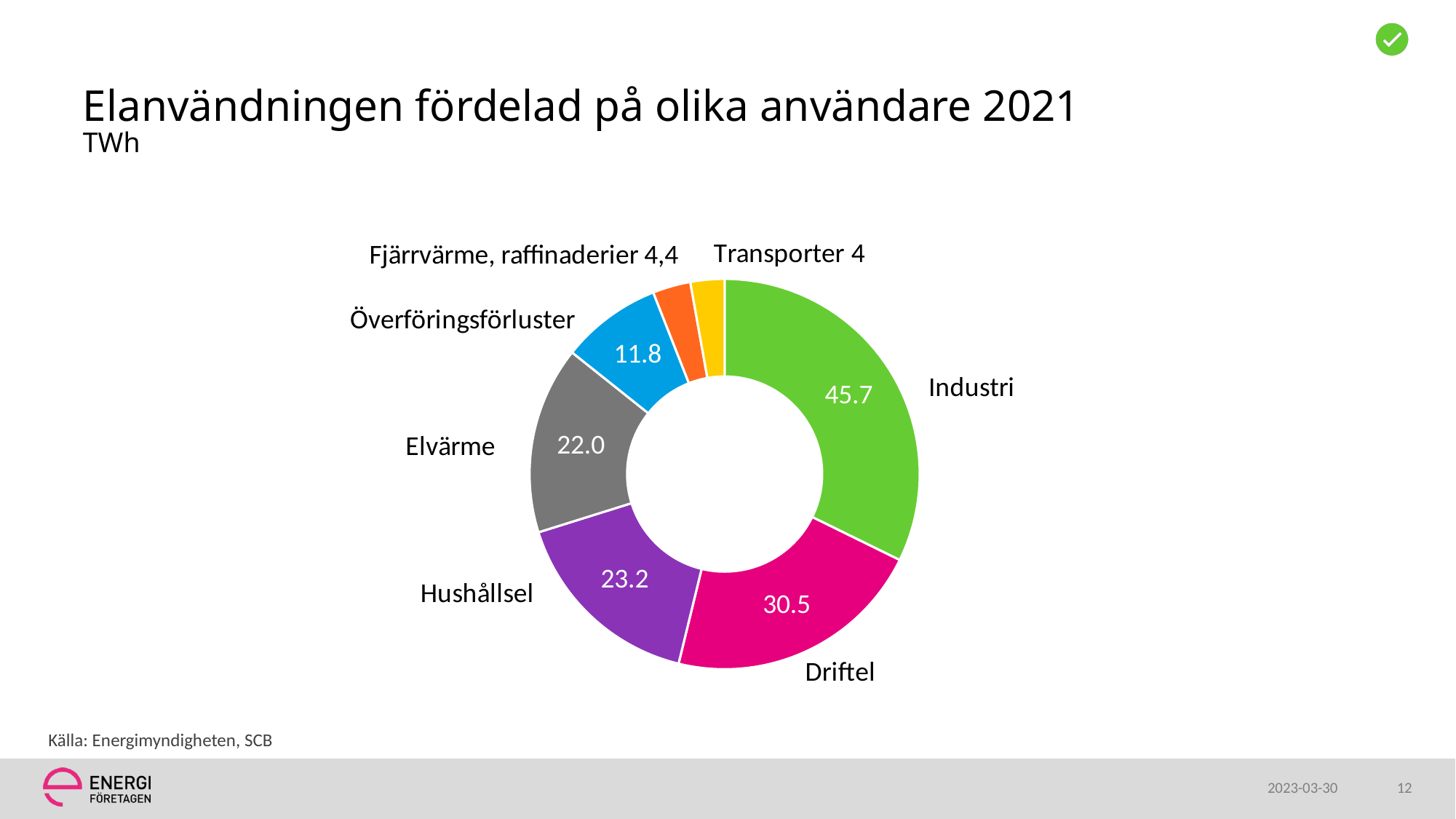
How many categories does the chart show? 7 Which category has the largest value? Industri What is the value for Industri? 45.7 Which category has the smallest value? Transporter What is the difference between the values for Hushållsel and Elvärme? 1.2 What unit is stated under the chart title? TWh What is the value for Överföringsförluster? 11.8 Which is larger, Hushållsel or Elvärme? Hushållsel What is the value for Fjärrvärme, raffinaderier? 4,4 What kind of chart is shown on the slide? Doughnut chart What is the value for Driftel? 30.5 What is the difference between the values for Industri and Driftel? 15.2